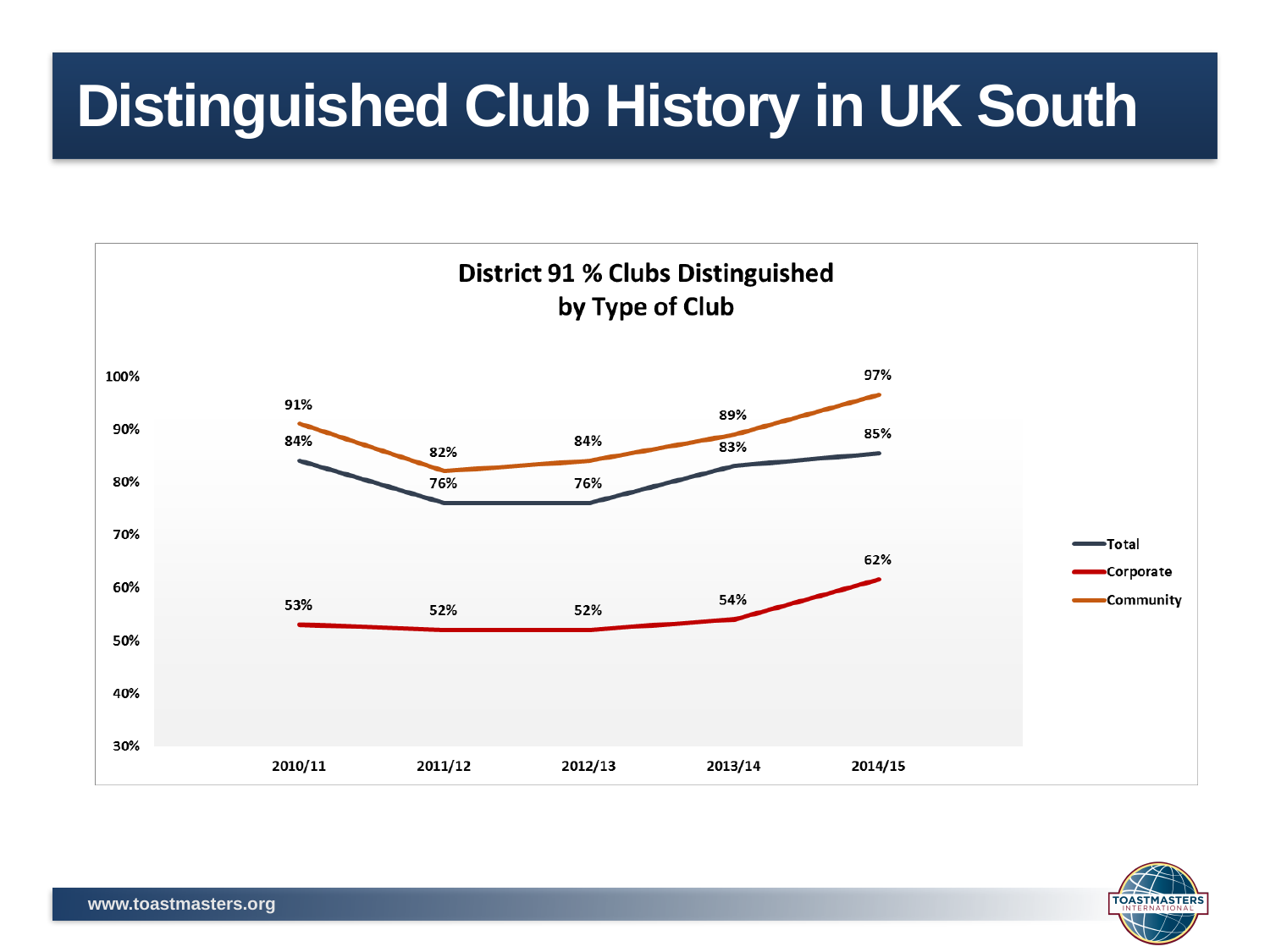
What is the Community value for 2014/15? 97% What colour is the Corporate line? Red What is the Corporate value for 2011/12? 52% How many series does the legend list? 3 Does the Corporate series rise or fall from 2013/14 to 2014/15? Rise Which is larger in 2012/13, the Total value or the Corporate value? Total What is the difference between the Community and Corporate values in 2010/11? 38% How many years are shown on the x axis? 5 In which year is the Community series at its lowest? 2011/12 What is the Total value for 2013/14? 83% In which year is the Corporate series at its highest? 2014/15 What kind of chart is shown? Line chart